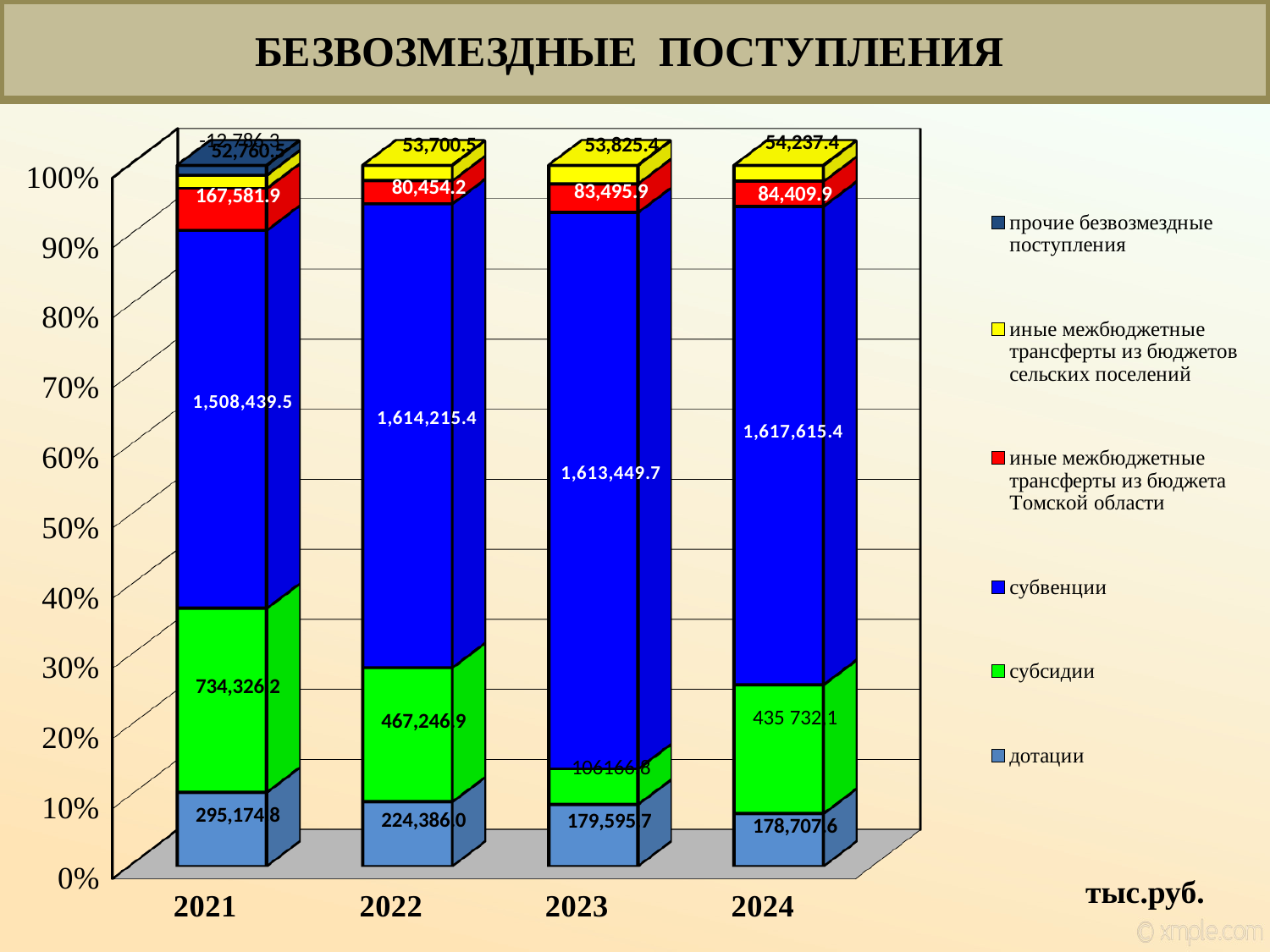
What kind of chart is shown on the slide? stacked bar chart Do the values of дотации rise or fall from 2021 to 2024? fall What is the value of субвенции for 2024? 1,617,615.4 In which year is the value of дотации the lowest? 2024 Which year has the larger value of субсидии, 2022 or 2024? 2022 What is the value of иные межбюджетные трансферты из бюджетов сельских поселений for 2023? 53,825.4 What is the difference between the дотации values for 2021 and 2022? 70,788.8 How many series does the legend list? 6 What is the value of дотации for 2021? 295,174.8 In which year is the value of субсидии the highest? 2021 What is the value of иные межбюджетные трансферты из бюджета Томской области for 2022? 80,454.2 How many years are shown on the x axis? 4